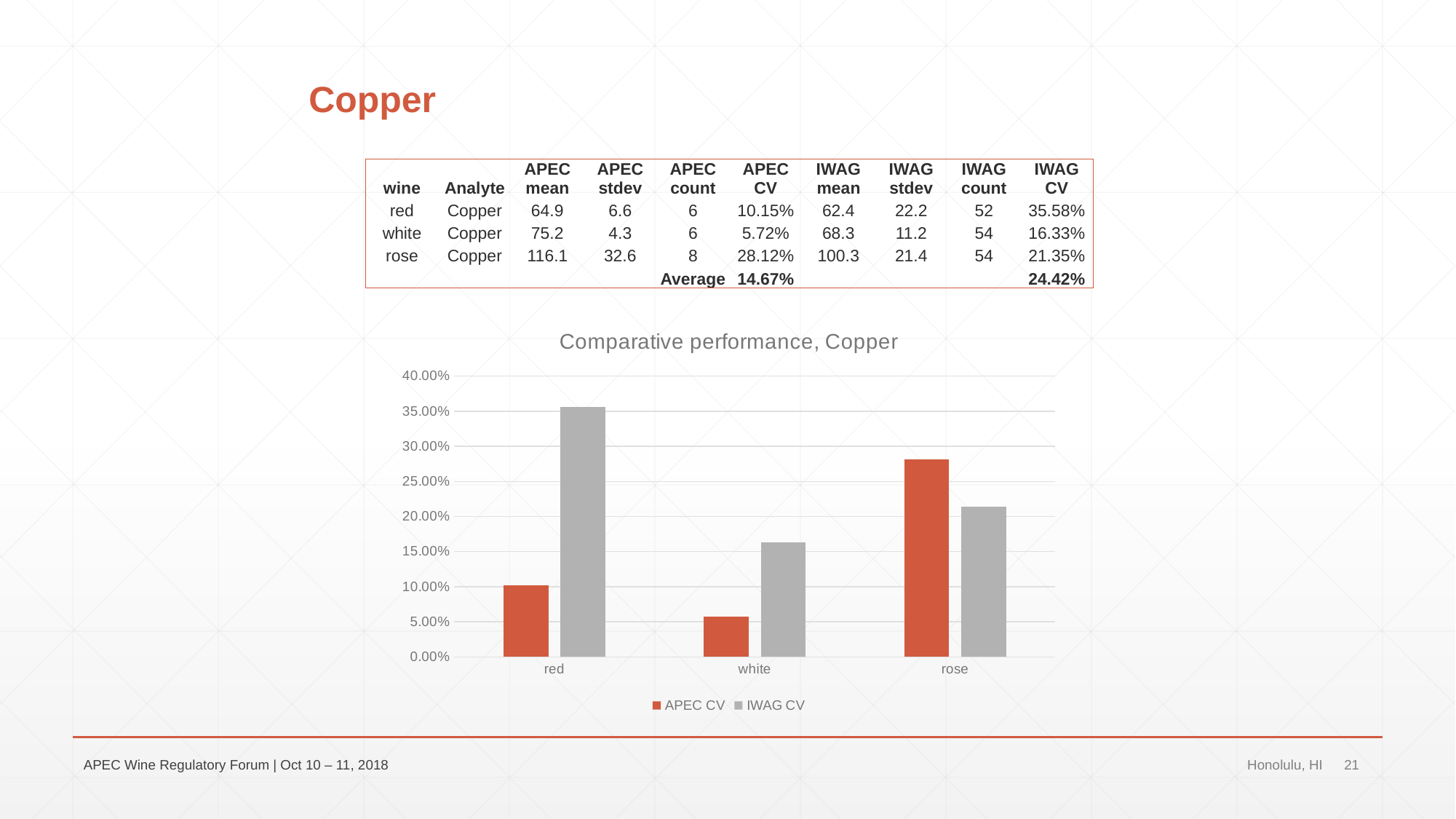
What is the APEC CV value for rose, as printed in the table on the slide? 28.12% For rose wine, which is larger in the chart: APEC CV or IWAG CV? APEC CV Is the IWAG CV value for red greater or less than 30.00%? greater What is the title of the chart? Comparative performance, Copper What kind of chart is shown on the slide? bar chart Which wine has the lowest APEC CV in the chart? white For red wine, which is larger in the chart: APEC CV or IWAG CV? IWAG CV Which wine has the highest IWAG CV in the chart? red Is the APEC CV value for white greater or less than 10.00%? less Using the values printed in the table, what is the difference between the IWAG CV and the APEC CV for red? 25.43% How many series does the legend of the chart list? 2 How many wine categories are shown on the x axis of the chart? 3